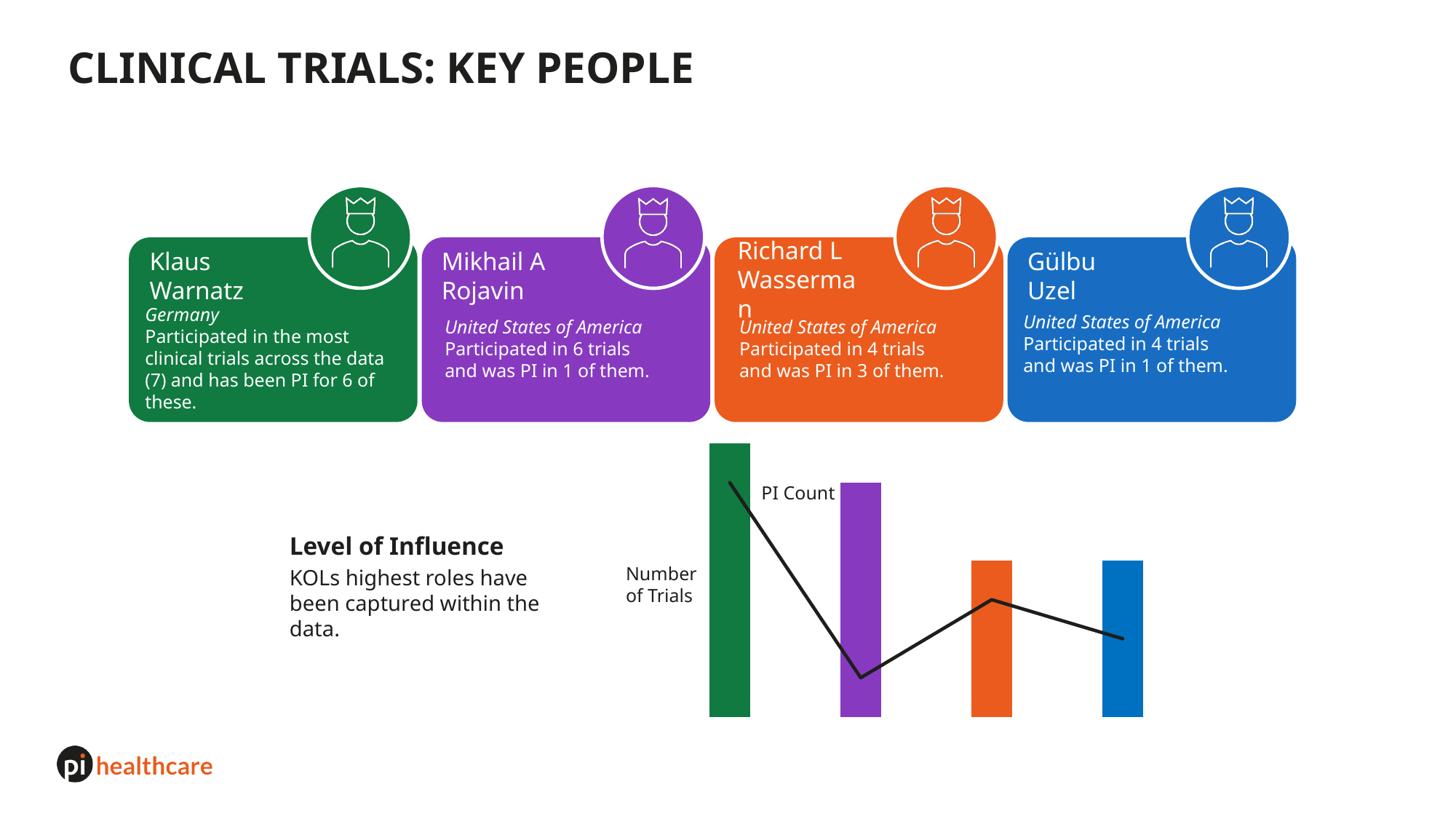
According to the slide, how many clinical trials did Klaus Warnatz participate in? 7 How many data series are labelled on the chart (Number of Trials and PI Count)? 2 How many bars does the chart at the bottom of the slide show? 4 What kind of chart is shown at the bottom of the slide? A bar chart with a line overlay What is the difference in number of trials between Klaus Warnatz (7) and Mikhail A Rojavin (6)? 1 Which person has the tallest bar for Number of Trials? Klaus Warnatz Which person has the highest point on the PI Count line? Klaus Warnatz Is the Number of Trials bar for Klaus Warnatz taller or shorter than the bar for Mikhail A Rojavin? Taller Do the Number of Trials bars generally rise or fall from left to right? Fall Which person does the green bar in the chart represent? Klaus Warnatz Is the PI Count for Richard L Wasserman higher or lower than the PI Count for Mikhail A Rojavin? Higher According to the slide, in how many trials was Richard L Wasserman PI? 3